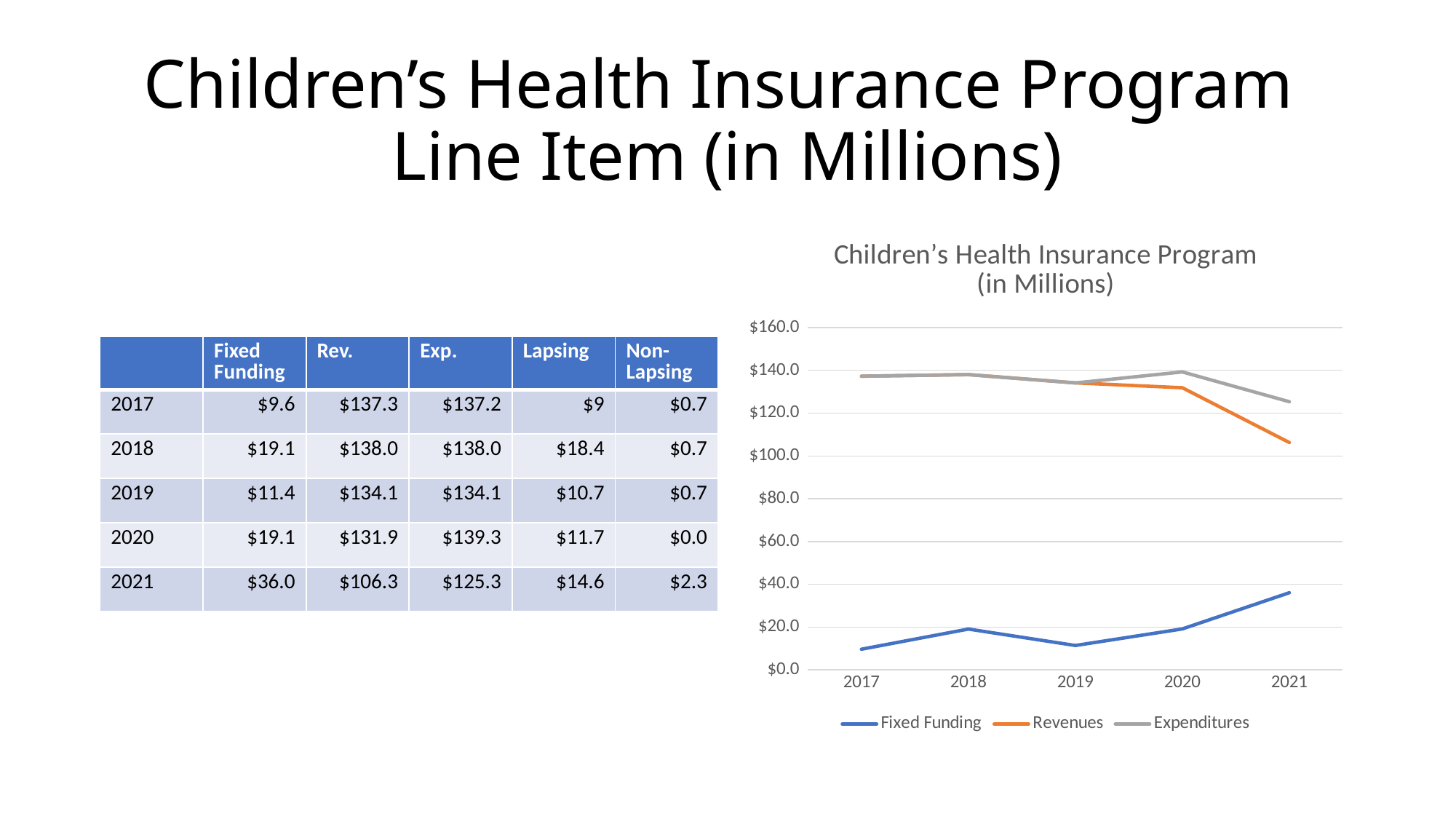
What is the Fixed Funding value for 2021? $36.0 Is the Fixed Funding value for 2021 greater or less than $40.0? less What kind of chart is shown on the slide? line chart What colour is the Fixed Funding line in the chart? blue Is the Revenues value for 2021 greater or less than $120.0? less How many series does the chart's legend list? 3 How many years are plotted along the x axis of the chart? 5 In which year is Fixed Funding highest in the chart? 2021 Do Revenues rise or fall from 2018 to 2021? fall In which year are Revenues lowest in the chart? 2021 In 2021, which is larger: Revenues or Expenditures? Expenditures What is the difference between Expenditures and Revenues in 2021? $19.0